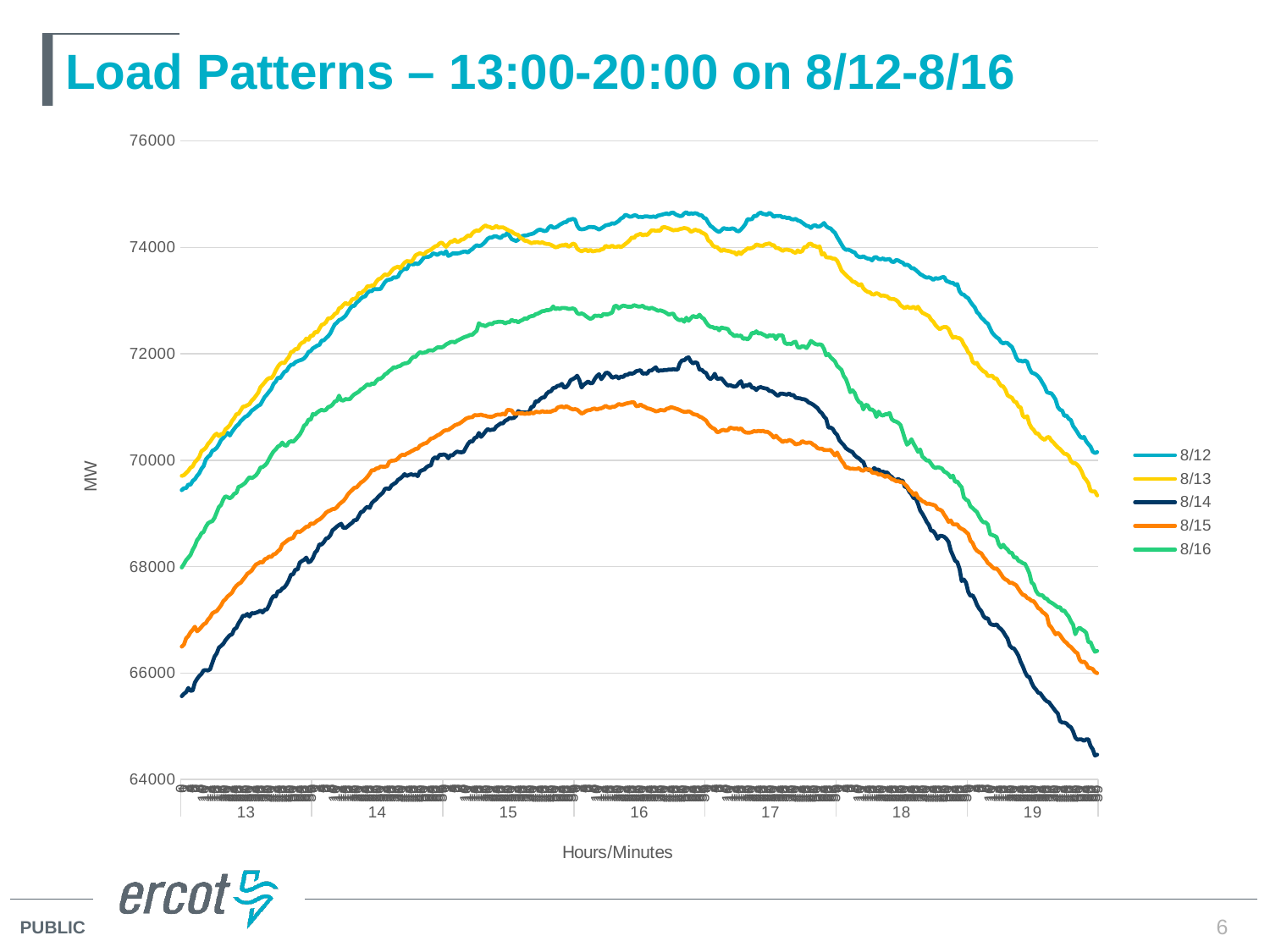
What is the label on the vertical axis? MW What kind of chart is shown on the slide? line chart How many series does the legend list? 5 Which series has the lowest value at the end of the period (just before 20:00)? 8/14 Which series reaches a higher peak, 8/12 or 8/14? 8/12 Is the value of the 8/15 line at hour 13 greater or less than 68000? less Is the peak value of the 8/16 line greater or less than 74000? less Is the peak value of the 8/12 line greater or less than 74000? greater Does the 8/15 line rise or fall between hour 13 and hour 15? rise Does the 8/12 line rise or fall between hour 18 and hour 19? fall What is the title of the chart? Load Patterns – 13:00-20:00 on 8/12-8/16